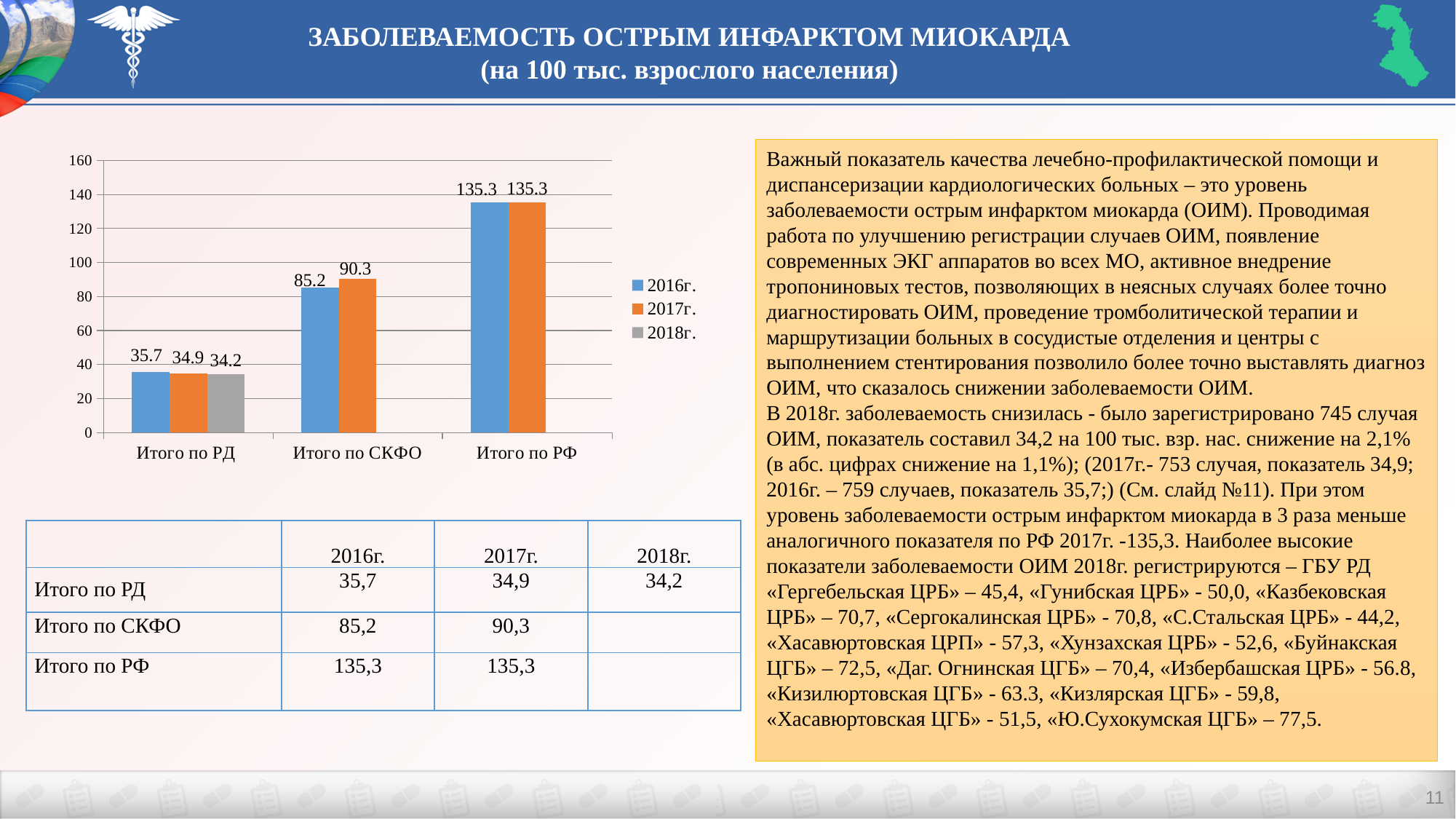
Which category has the highest value in the 2017г. series? Итого по РФ Which is larger for Итого по СКФО: the 2016г. value or the 2017г. value? 2017г. What is the value for Итого по РД in the 2018г. series? 34.2 Which category has the lowest value in the 2016г. series? Итого по РД Is the 2017г. value for Итого по РФ greater or less than 120? greater What is the difference between the 2016г. and 2018г. values for Итого по РД? 1.5 What is the value for Итого по СКФО in the 2017г. series? 90.3 What is the difference between the 2017г. and 2016г. values for Итого по СКФО? 5.1 What is the value for Итого по РФ in the 2016г. series? 135.3 How many categories are shown on the x axis of the chart? 3 What kind of chart is shown on the slide? bar chart How many series does the chart legend list? 3